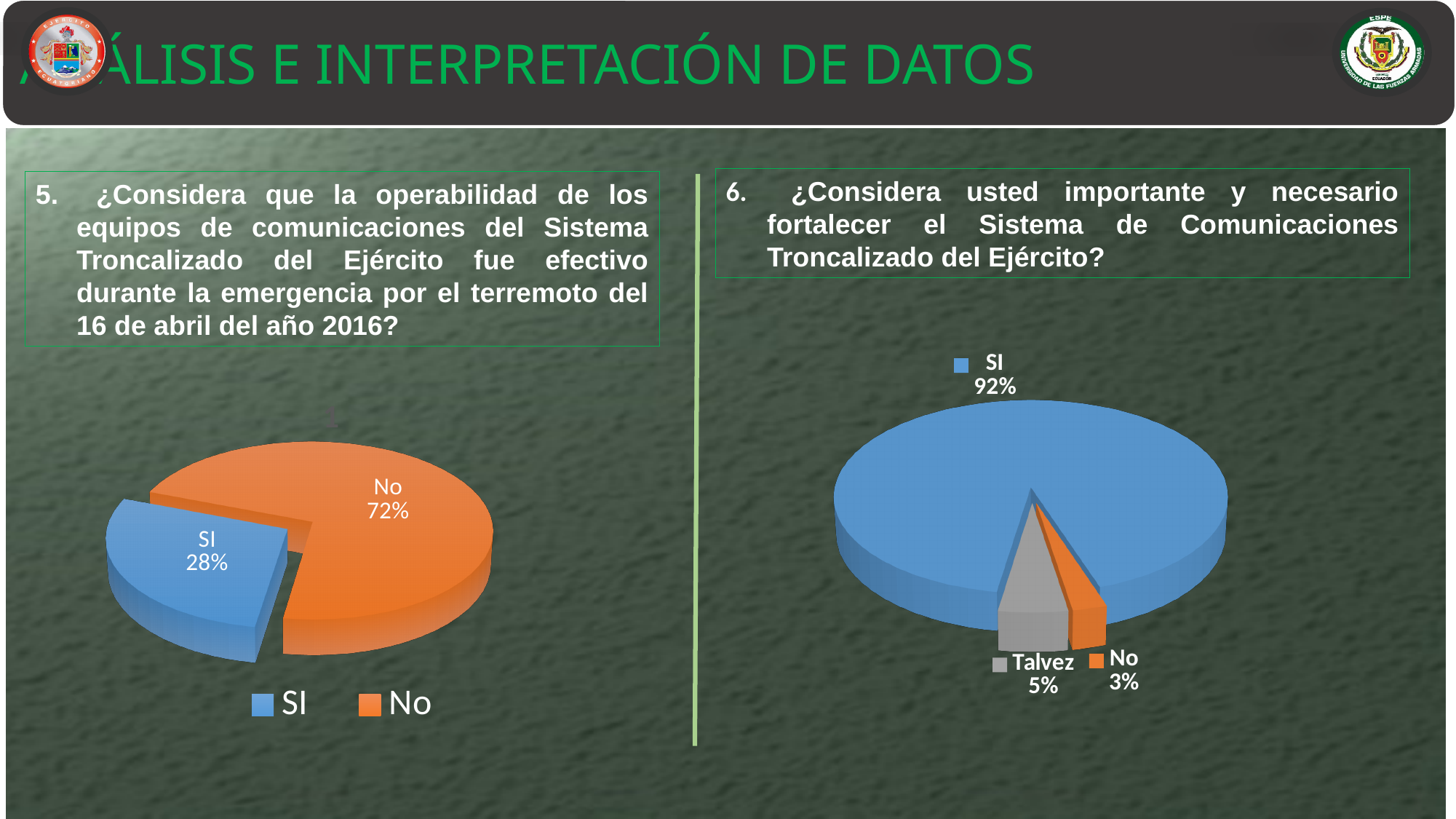
In the left pie chart (question 5), which response has the largest share? No In the left pie chart (question 5), what percentage answered SI? 28% In the right pie chart (question 6), what percentage answered No? 3% In the right pie chart (question 6), which colour represents the SI slice? Blue In the right pie chart (question 6), which response has the smallest share? No In the right pie chart (question 6), what percentage answered SI? 92% In the left pie chart (question 5), what percentage answered No? 72% What kind of chart is shown on the left side of the slide (question 5)? Pie chart In the left pie chart (question 5), how many slices does the pie have? 2 In the right pie chart (question 6), how many response categories are shown? 3 In the right pie chart (question 6), what percentage answered Talvez? 5% In the left pie chart (question 5), what is the difference in percentage points between No and SI? 44